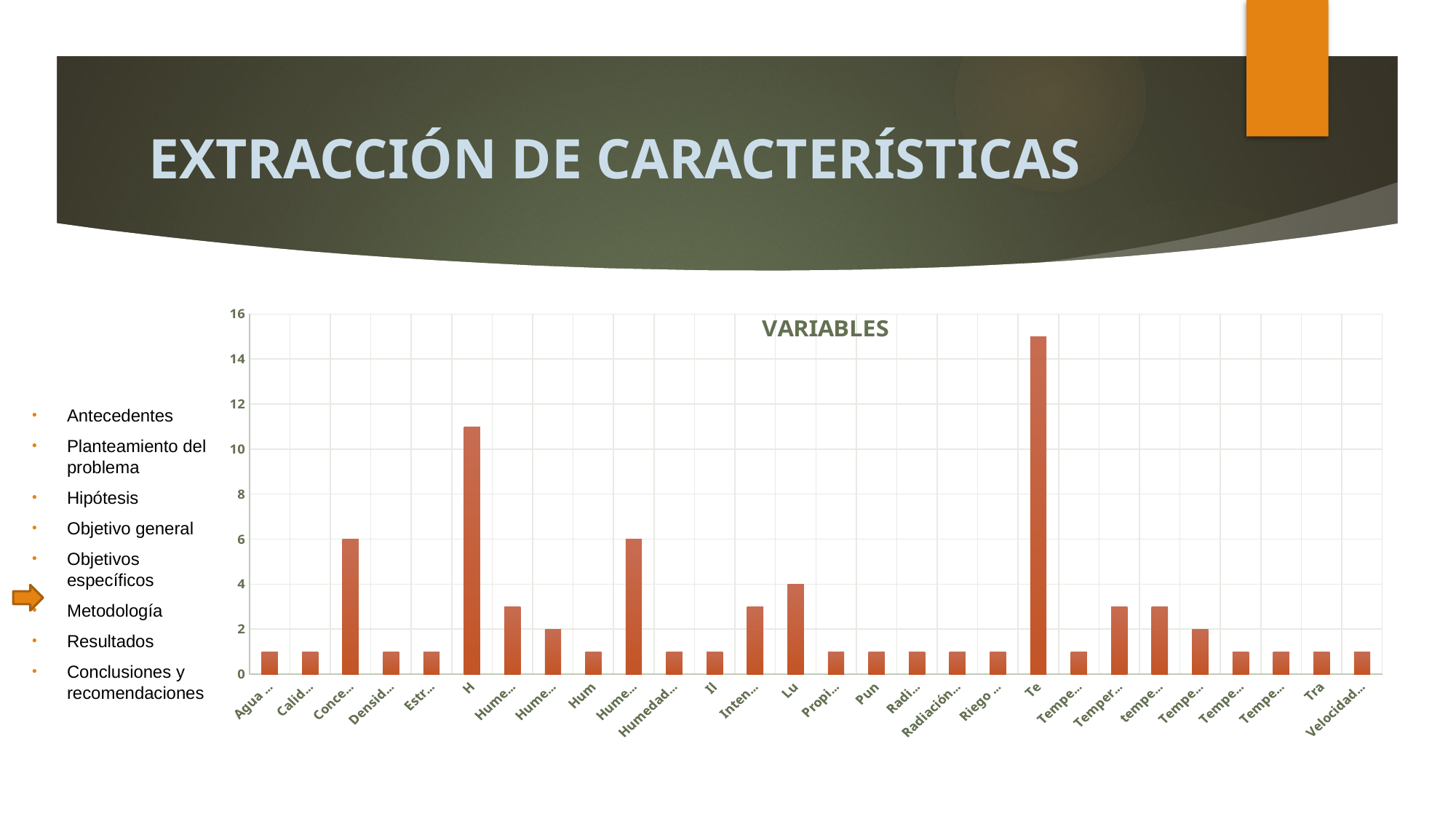
What is the value for Lu in the VARIABLES chart? 4 Is the value for Te greater or less than 14? greater Which is larger, the value for Te or the value for H? Te Is the value for Tra greater or less than 2? less What is the title of the chart? VARIABLES Which is larger, the value for H or the value for Lu? H Which is larger, the value for Lu or the value for Pun? Lu Is the value for H greater or less than 10? greater How many bars (categories) are plotted in the VARIABLES chart? 28 Which category has the highest bar in the VARIABLES chart? Te What kind of chart is shown on the slide? bar chart